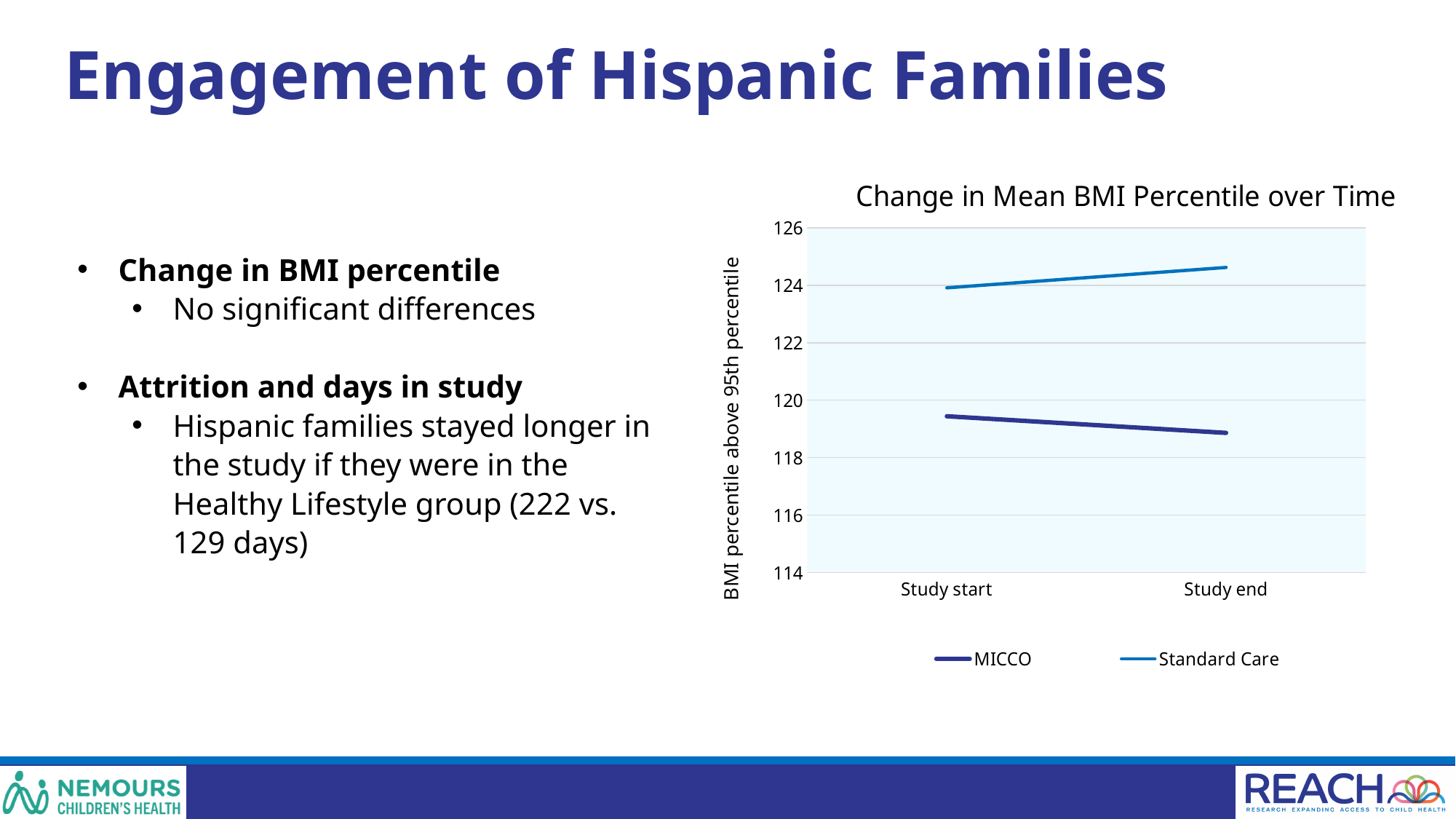
How many time points are shown on the x axis of the chart? 2 What kind of chart is shown on the slide? Line chart Which series has the higher value at Study start, MICCO or Standard Care? Standard Care Is the value for MICCO at Study start greater or less than 120? less What is the label on the y axis of the chart? BMI percentile above 95th percentile Is the value for Standard Care at Study end greater or less than 124? greater Does the MICCO line rise or fall from Study start to Study end? Fall How many series does the legend of the chart list? 2 Which series has the lower value at Study end, MICCO or Standard Care? MICCO What is the title of the chart? Change in Mean BMI Percentile over Time Does the Standard Care line rise or fall from Study start to Study end? Rise Is the value for MICCO at Study end greater or less than 118? greater